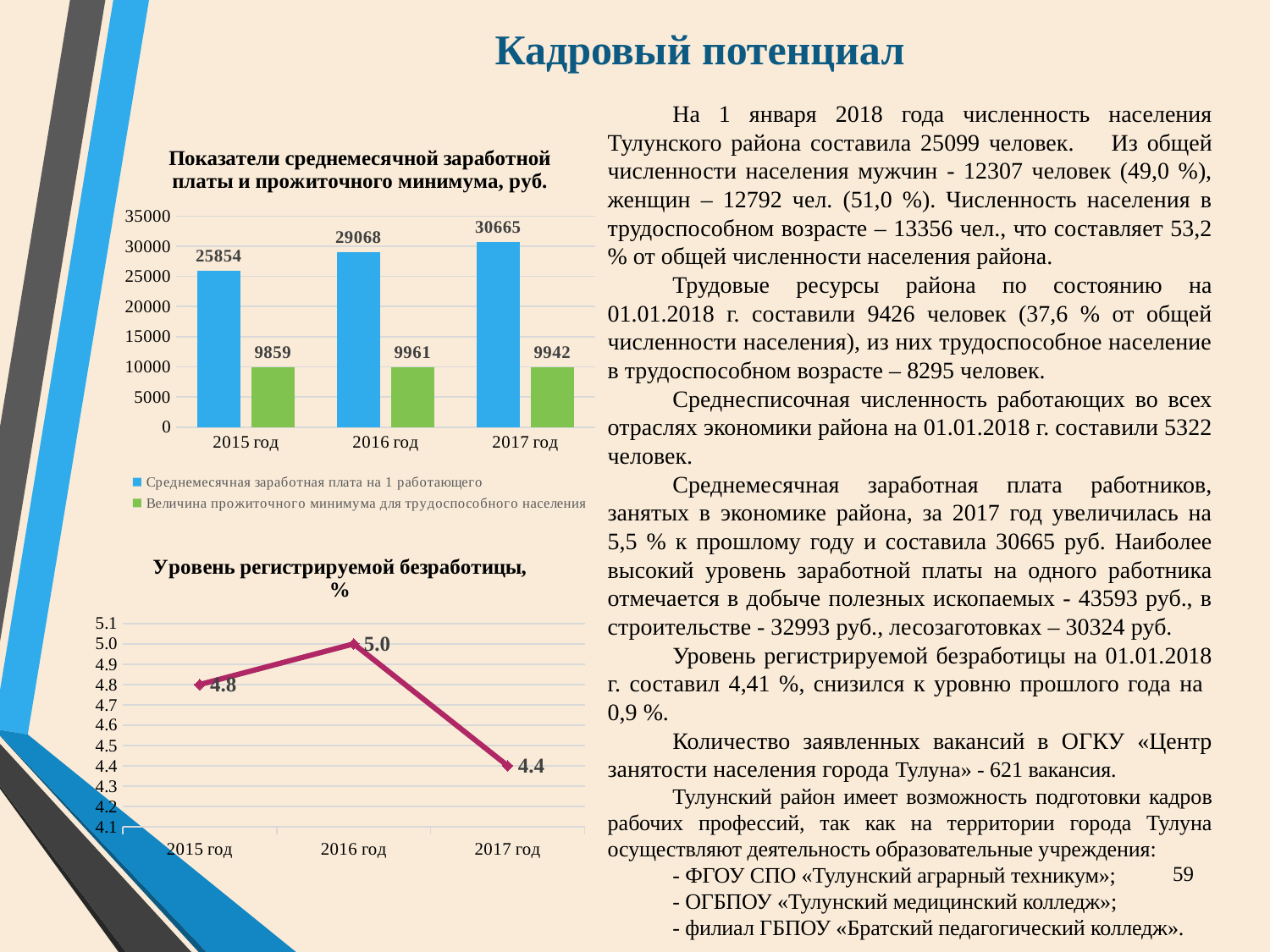
In the chart 'Показатели среднемесячной заработной платы и прожиточного минимума, руб.', what is the subsistence minimum for the working-age population in 2015 год? 9859 In the chart 'Уровень регистрируемой безработицы, %', what is the difference between the values for 2016 год and 2017 год? 0.6 What kind of chart is 'Показатели среднемесячной заработной платы и прожиточного минимума, руб.'? bar chart In the chart 'Показатели среднемесячной заработной платы и прожиточного минимума, руб.', how many series does the legend list? 2 In the chart 'Уровень регистрируемой безработицы, %', what is the value for 2016 год? 5.0 What kind of chart is 'Уровень регистрируемой безработицы, %'? line chart In the chart 'Уровень регистрируемой безработицы, %', which year has the lowest unemployment rate? 2017 год In the chart 'Показатели среднемесячной заработной платы и прожиточного минимума, руб.', which year has the highest average monthly wage? 2017 год In the chart 'Показатели среднемесячной заработной платы и прожиточного минимума, руб.', what is the difference between the average monthly wage in 2017 год and in 2015 год? 4811 In the chart 'Показатели среднемесячной заработной платы и прожиточного минимума, руб.', which year has the lowest subsistence minimum? 2015 год In the chart 'Показатели среднемесячной заработной платы и прожиточного минимума, руб.', what is the average monthly wage per worker in 2016 год? 29068 In the chart 'Показатели среднемесячной заработной платы и прожиточного минимума, руб.', does the average monthly wage rise or fall from 2015 год to 2017 год? rise